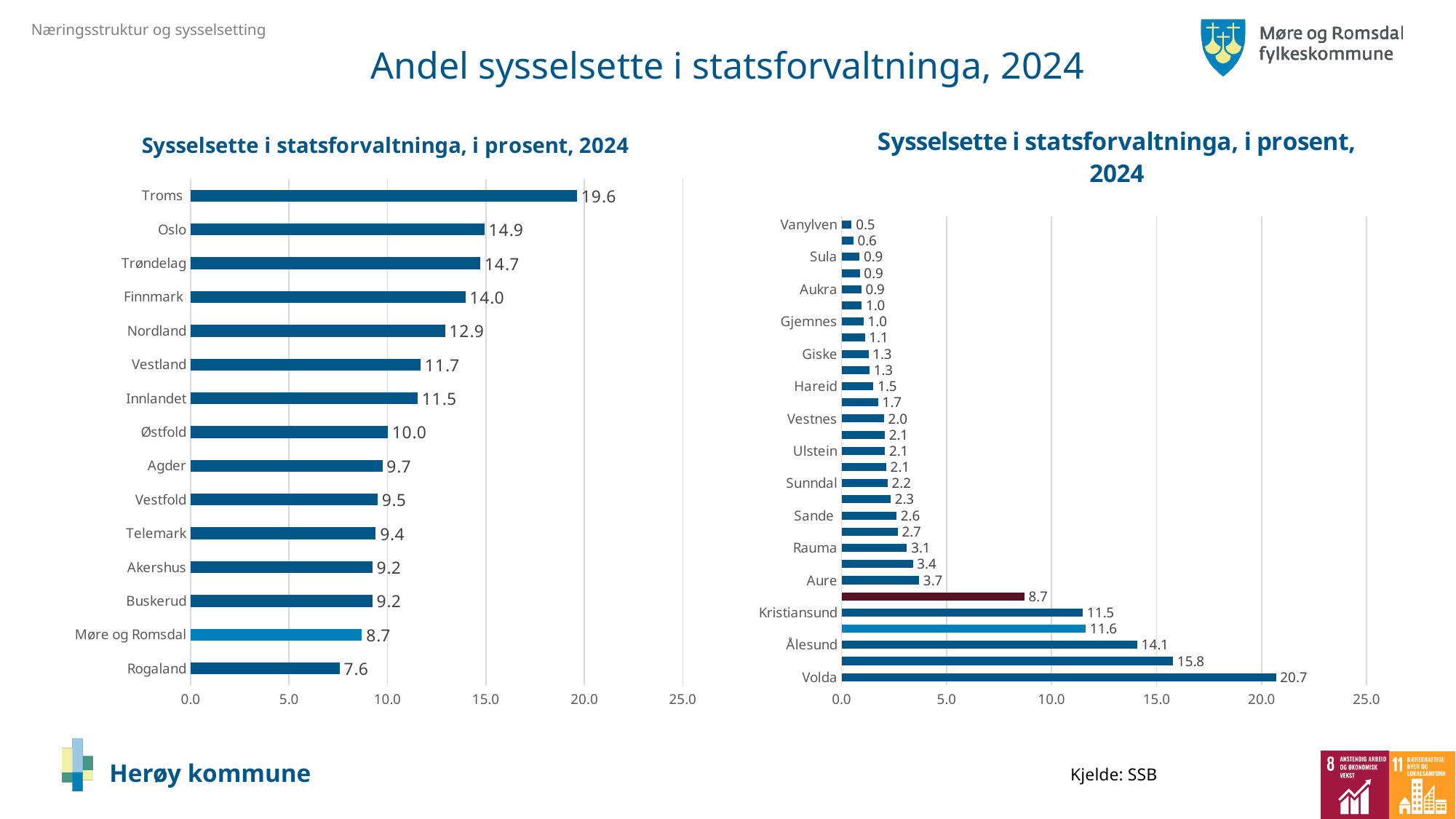
In the left chart, what is the value for Troms? 19.6 In the left chart, what is the difference between the values for Oslo and Rogaland? 7.3 In the left chart, what is the value for Møre og Romsdal? 8.7 How many categories are shown in the left chart? 15 In the right chart, is the value for Rauma greater or less than 5.0? less In the right chart, what is the value for Volda? 20.7 In the right chart, which labelled category has the highest value? Volda In the left chart, which is larger, the value for Nordland or the value for Vestland? Nordland In the right chart, what is the value for Kristiansund? 11.5 In the right chart, what is the difference between the values for Ålesund and Aure? 10.4 What type of chart is the left chart? Bar chart In the left chart, which category has the lowest value? Rogaland